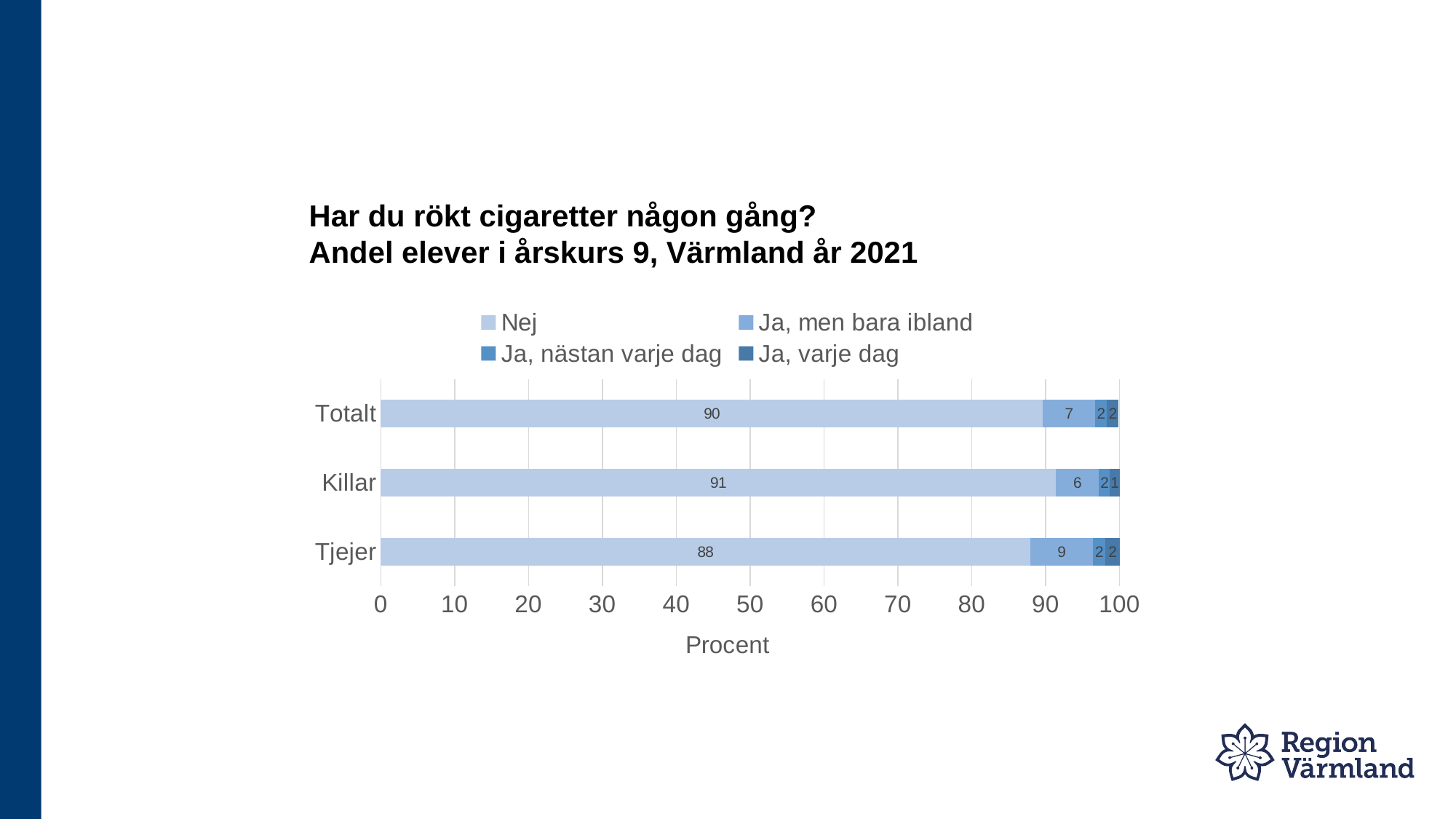
Which category has the highest value for "Nej"? Killar What is the value of "Ja, men bara ibland" for Totalt? 7 What is the value of "Ja, varje dag" for Killar? 1 What is the value of "Ja, men bara ibland" for Killar? 6 What is the value of "Nej" for Tjejer? 88 Which category has the lowest value for "Nej"? Tjejer What is the label of the x axis? Procent What is the difference between the "Nej" values for Killar and Tjejer? 3 What kind of chart is shown on the slide? Stacked bar chart How many categories are shown on the y axis? 3 Which is larger, the "Ja, men bara ibland" value for Tjejer or for Killar? Tjejer How many series does the legend list? 4